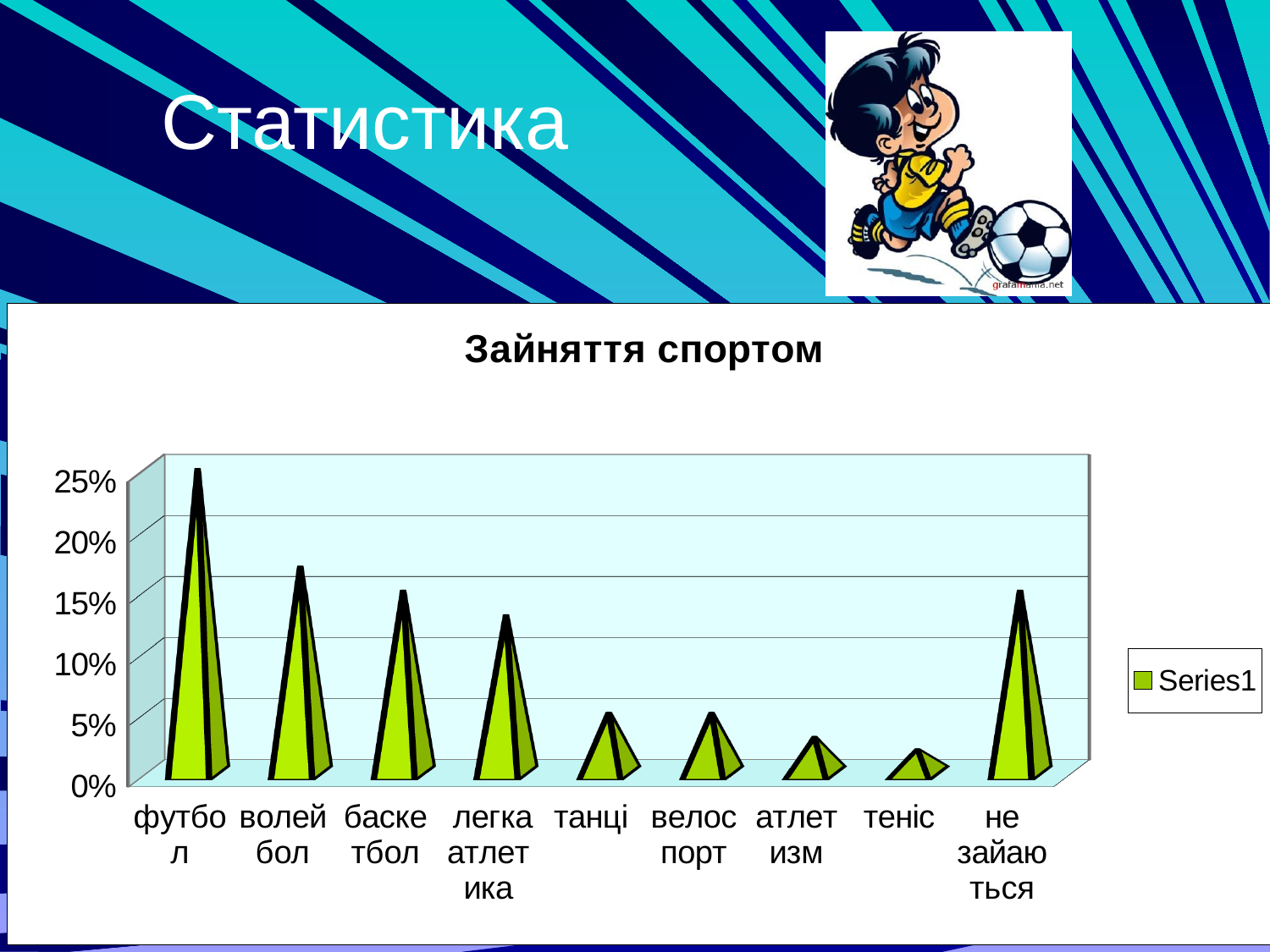
How many categories are shown on the x axis of the chart? 9 How many series does the legend list? 1 Is the value for футбол greater or less than 20%? greater Is the value for не займаються greater or less than 10%? greater Is the value for теніс greater or less than 5%? less What kind of chart is shown on the slide? bar chart What is the title of the chart? Зайняття спортом Which is larger, the value for футбол or the value for волейбол? футбол What is the name of the series shown in the legend? Series1 Which category has the highest value? футбол Which category has the lowest value? теніс Which is larger, the value for танці or the value for теніс? танці